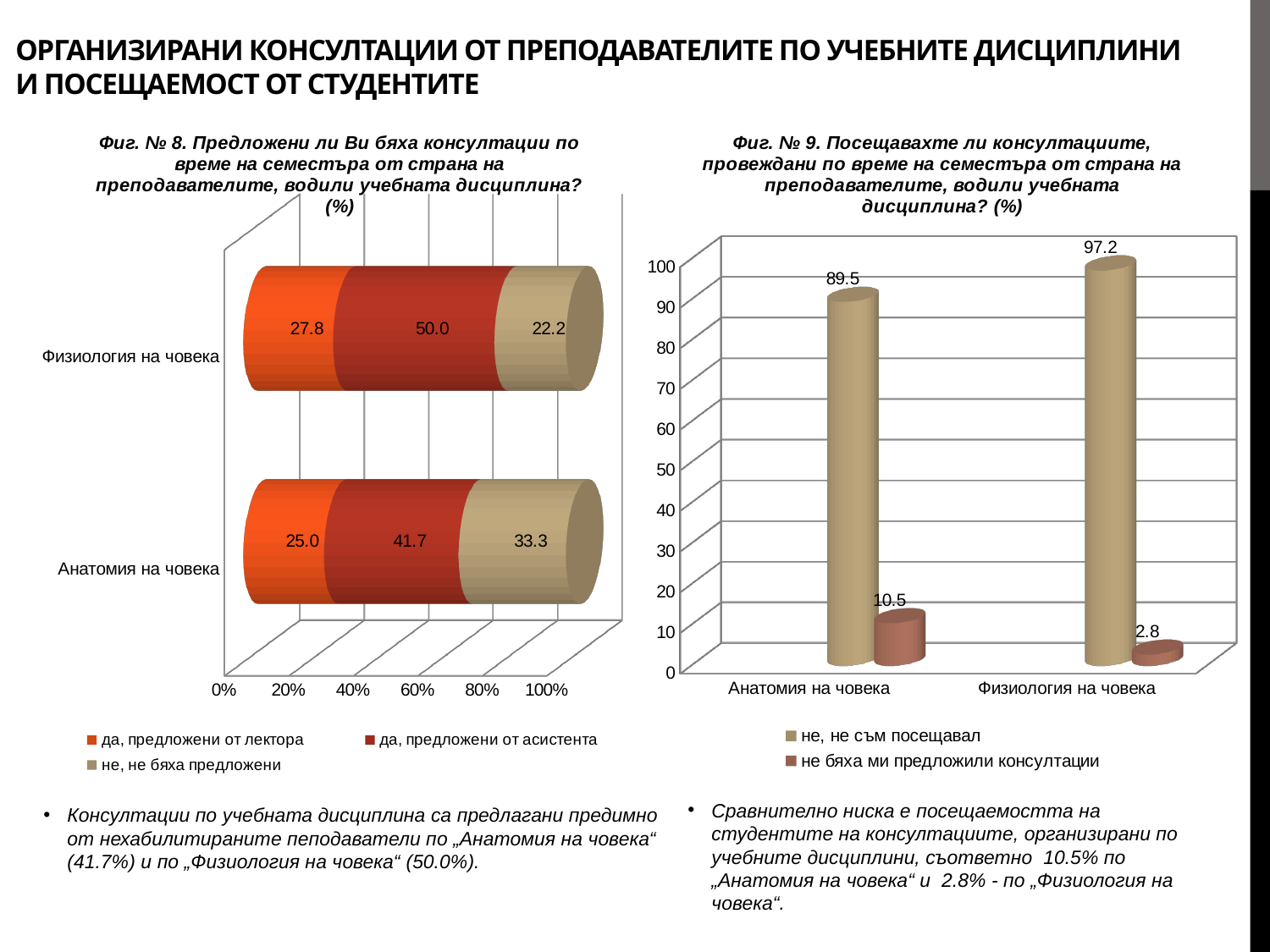
In Фиг. № 8, what is the value for "не, не бяха предложени" for Физиология на човека? 22.2 In Фиг. № 8, what is the total of the stacked bar for Анатомия на човека? 100.0 In Фиг. № 9, what is the difference between the "не, не съм посещавал" values for Физиология на човека and Анатомия на човека? 7.7 In Фиг. № 8, what is the value for "да, предложени от асистента" for Анатомия на човека? 41.7 In Фиг. № 8, what is the difference between the "не, не бяха предложени" values for Анатомия на човека and Физиология на човека? 11.1 In Фиг. № 9, what is the value for "не, не съм посещавал" for Физиология на човека? 97.2 In Фиг. № 9, which category has the lowest value for "не бяха ми предложили консултации"? Физиология на човека In Фиг. № 8, which series has the highest value for Физиология на човека? да, предложени от асистента What kind of chart is Фиг. № 9? bar chart In Фиг. № 8, how many series does the legend list? 3 In Фиг. № 9, what is the value for "не бяха ми предложили консултации" for Анатомия на човека? 10.5 In Фиг. № 9, how many categories are shown on the x axis? 2